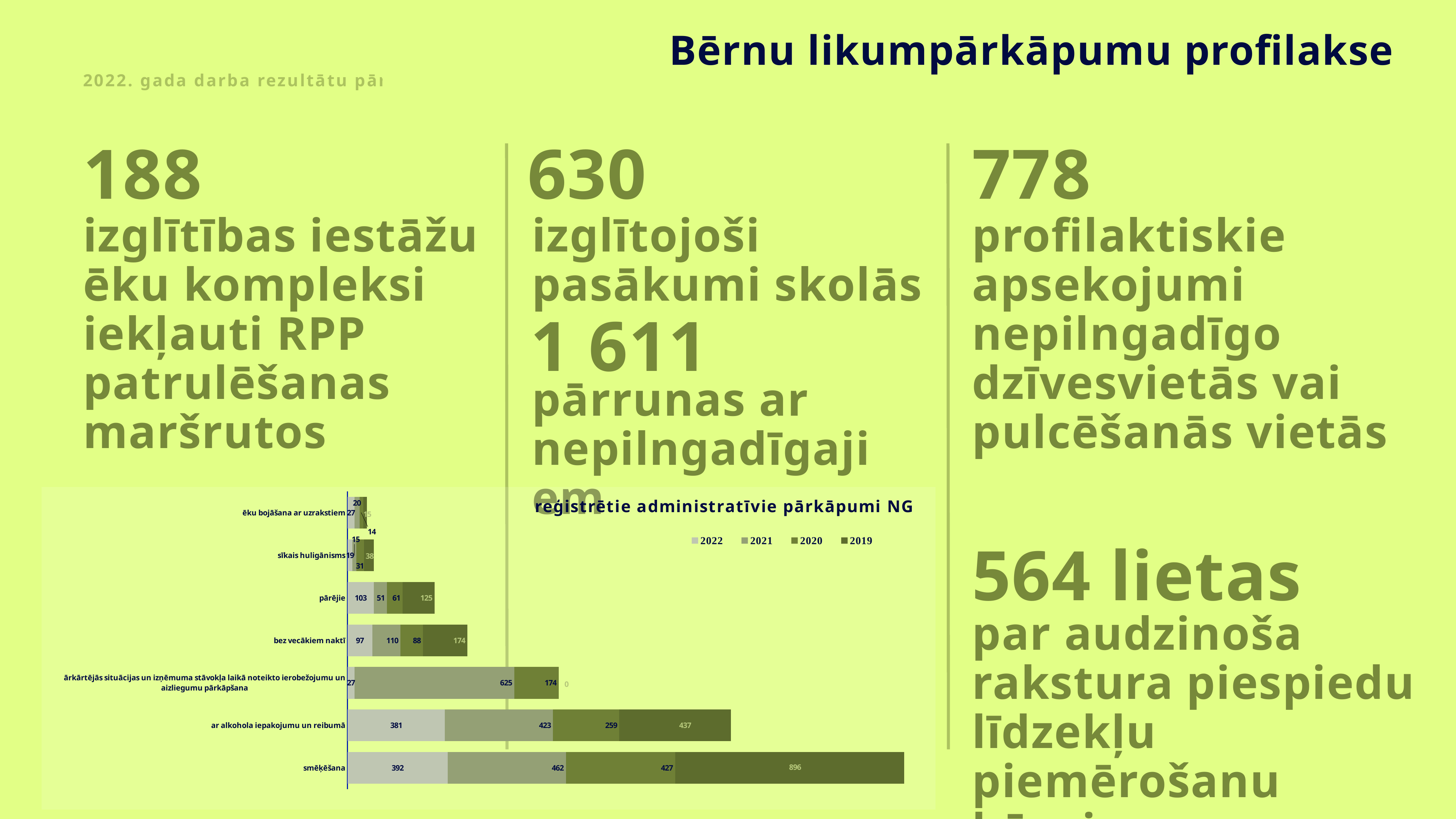
What is the title of the chart on the slide? reģistrētie administratīvie pārkāpumi NG What is the 2019 value for smēķēšana? 896 Which is larger for bez vecākiem naktī: the 2021 value or the 2020 value? 2021 Which category has the longest total bar in the chart? smēķēšana What is the difference between the 2019 and 2020 values for smēķēšana? 469 How many categories are shown in the chart? 7 What is the total of the stacked bar for ar alkohola iepakojumu un reibumā? 1500 What kind of chart is shown at the bottom of the slide? stacked bar chart How many series does the chart legend list? 4 What is the 2022 value for bez vecākiem naktī? 97 What is the 2021 value for ar alkohola iepakojumu un reibumā? 423 What is the 2020 value for pārējie? 61